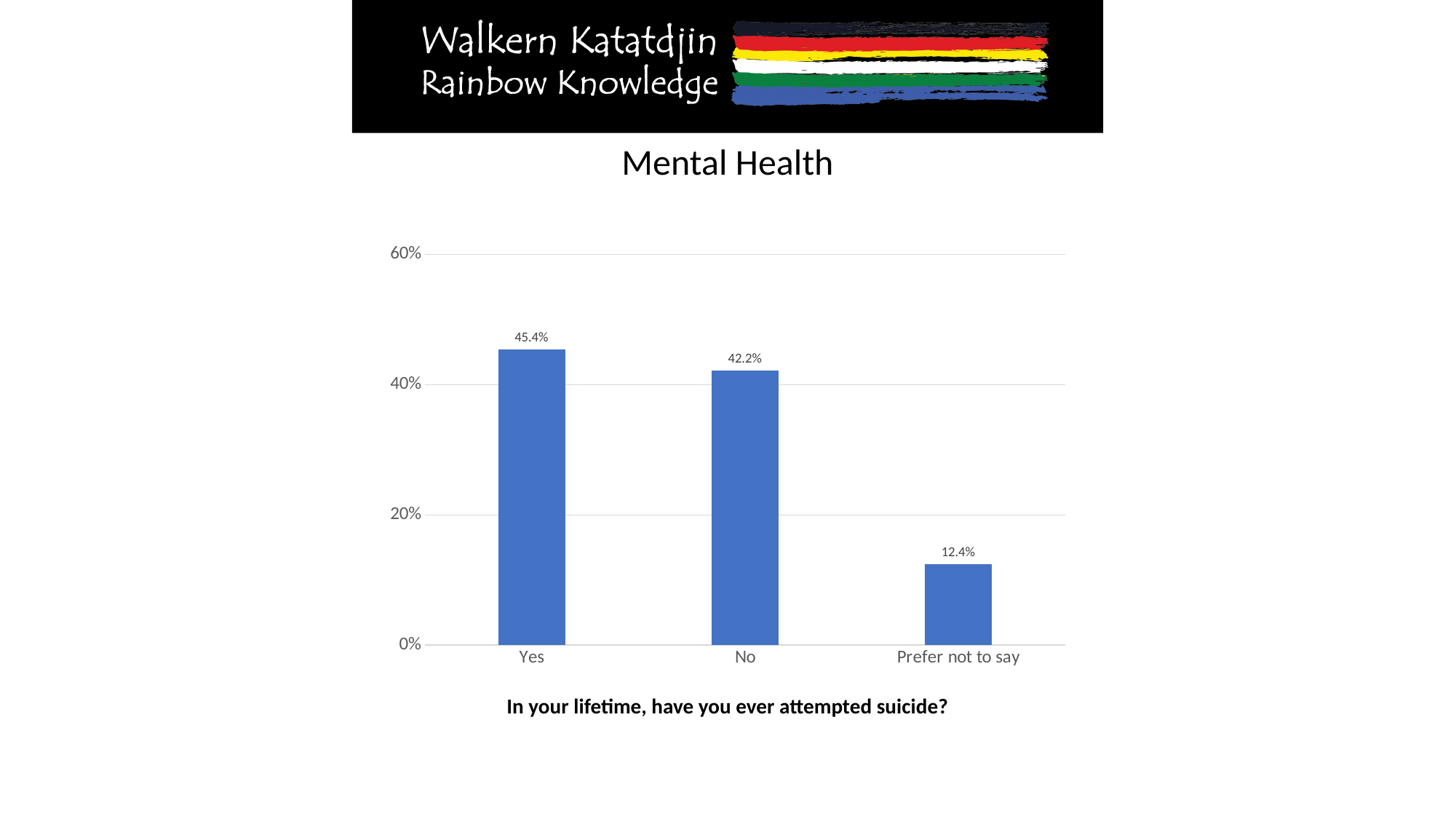
What is the difference in percentage points between the "No" and "Prefer not to say" responses? 29.8 percentage points What survey question is written below the chart? In your lifetime, have you ever attempted suicide? What kind of chart is shown on the slide? Bar chart Which response category has the highest percentage? Yes What percentage of respondents answered "No"? 42.2% What percentage of respondents answered "Yes" to the question "In your lifetime, have you ever attempted suicide?" 45.4% What percentage of respondents chose "Prefer not to say"? 12.4% How many response categories are shown on the x axis? 3 Is the value for "No" greater or less than 40%? greater Which response category has the lowest percentage? Prefer not to say What is the difference in percentage points between the "Yes" and "No" responses? 3.2 percentage points Which is larger, the percentage for "Yes" or the percentage for "Prefer not to say"? Yes